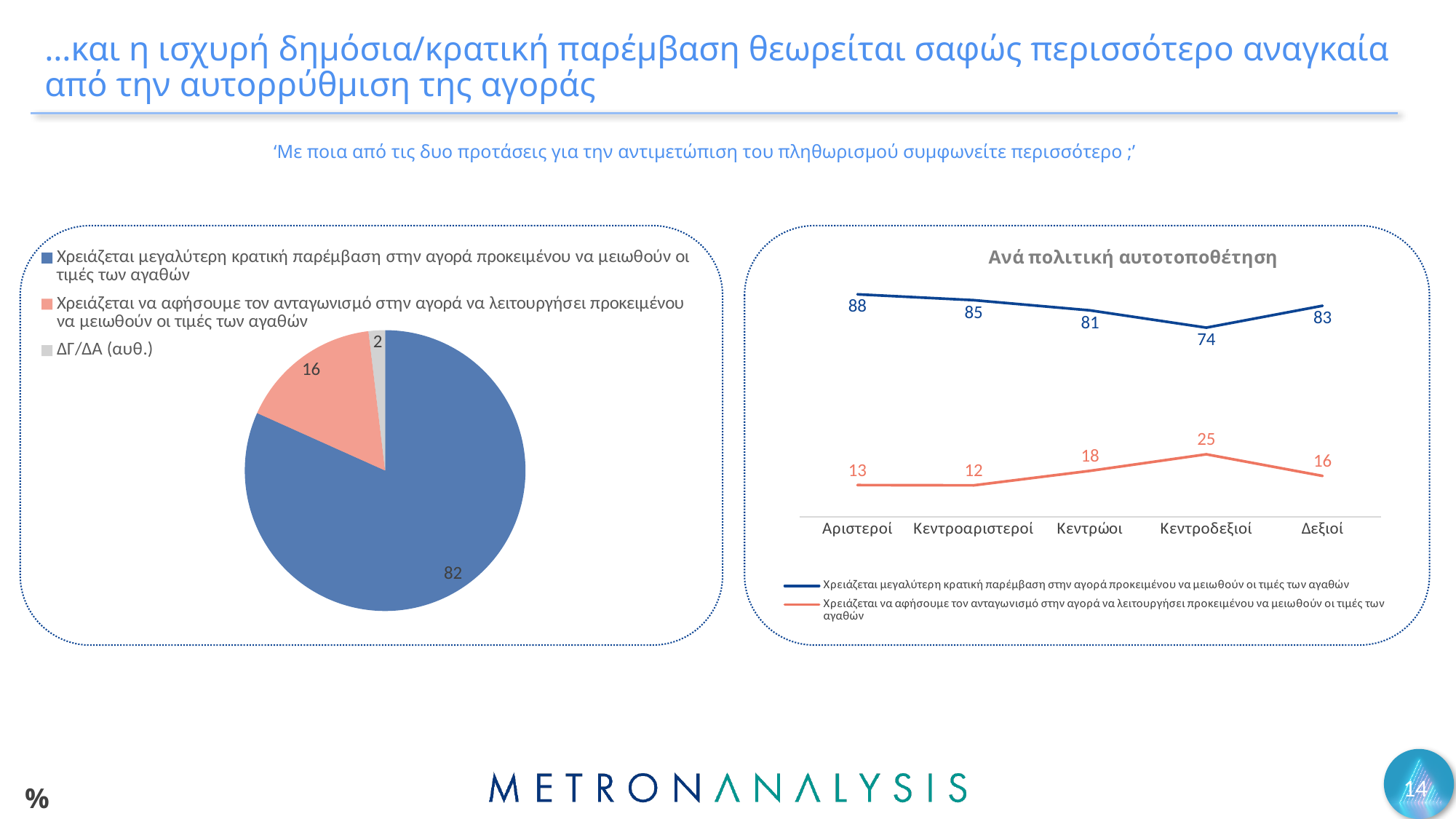
In the pie chart on the left, what is the value for 'ΔΓ/ΔΑ (αυθ.)'? 2 What kind of chart is the chart on the left of the slide? pie chart In the chart 'Ανά πολιτική αυτοτοποθέτηση', how many series does the legend list? 2 In the chart 'Ανά πολιτική αυτοτοποθέτηση', what is the difference between the two series for Δεξιοί? 67 In the pie chart on the left, which slice is the smallest? ΔΓ/ΔΑ (αυθ.) In the chart 'Ανά πολιτική αυτοτοποθέτηση', for which category is the 'Χρειάζεται μεγαλύτερη κρατική παρέμβαση' series highest? Αριστεροί What kind of chart is the chart titled 'Ανά πολιτική αυτοτοποθέτηση'? line chart In the pie chart on the left, how many slices are there? 3 In the chart 'Ανά πολιτική αυτοτοποθέτηση', how many categories are shown on the x axis? 5 In the chart 'Ανά πολιτική αυτοτοποθέτηση', what is the value of the 'Χρειάζεται να αφήσουμε τον ανταγωνισμό' series for Κεντρώοι? 18 In the chart 'Ανά πολιτική αυτοτοποθέτηση', what is the value of the 'Χρειάζεται μεγαλύτερη κρατική παρέμβαση' series for Κεντροδεξιοί? 74 In the pie chart on the left, what is the value for 'Χρειάζεται μεγαλύτερη κρατική παρέμβαση στην αγορά προκειμένου να μειωθούν οι τιμές των αγαθών'? 82